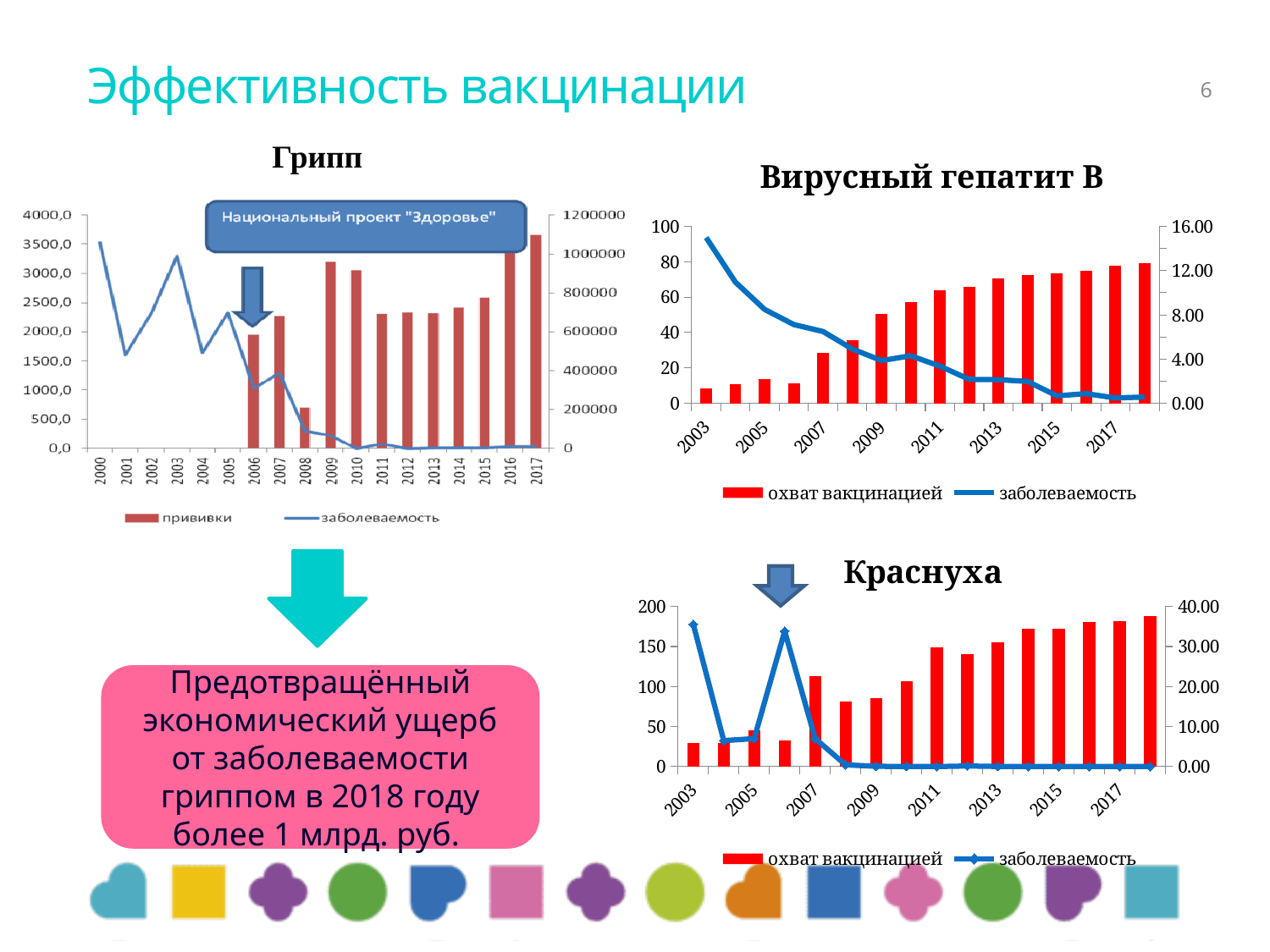
In the "Грипп" chart, which year has the highest bar for прививки? 2017 How many series does the legend of the "Краснуха" chart list? 2 In the "Грипп" chart, which year has the lowest bar for прививки? 2008 How many charts are shown on the slide? 3 In the "Грипп" chart, does the заболеваемость line rise or fall overall from 2000 to 2017? Fall In the "Вирусный гепатит В" chart, does the заболеваемость line rise or fall from 2003 to 2018? Fall In the "Вирусный гепатит В" chart, which year has the lowest bar for охват вакцинацией? 2003 In the "Вирусный гепатит В" chart, is the охват вакцинацией value for 2011 greater or less than 60? greater In the "Вирусный гепатит В" chart, is the заболеваемость value for 2003 greater or less than 12.00? greater In the "Краснуха" chart, is the охват вакцинацией value for 2008 greater or less than 100? less What kind of chart is the "Вирусный гепатит В" chart? Combined bar and line chart